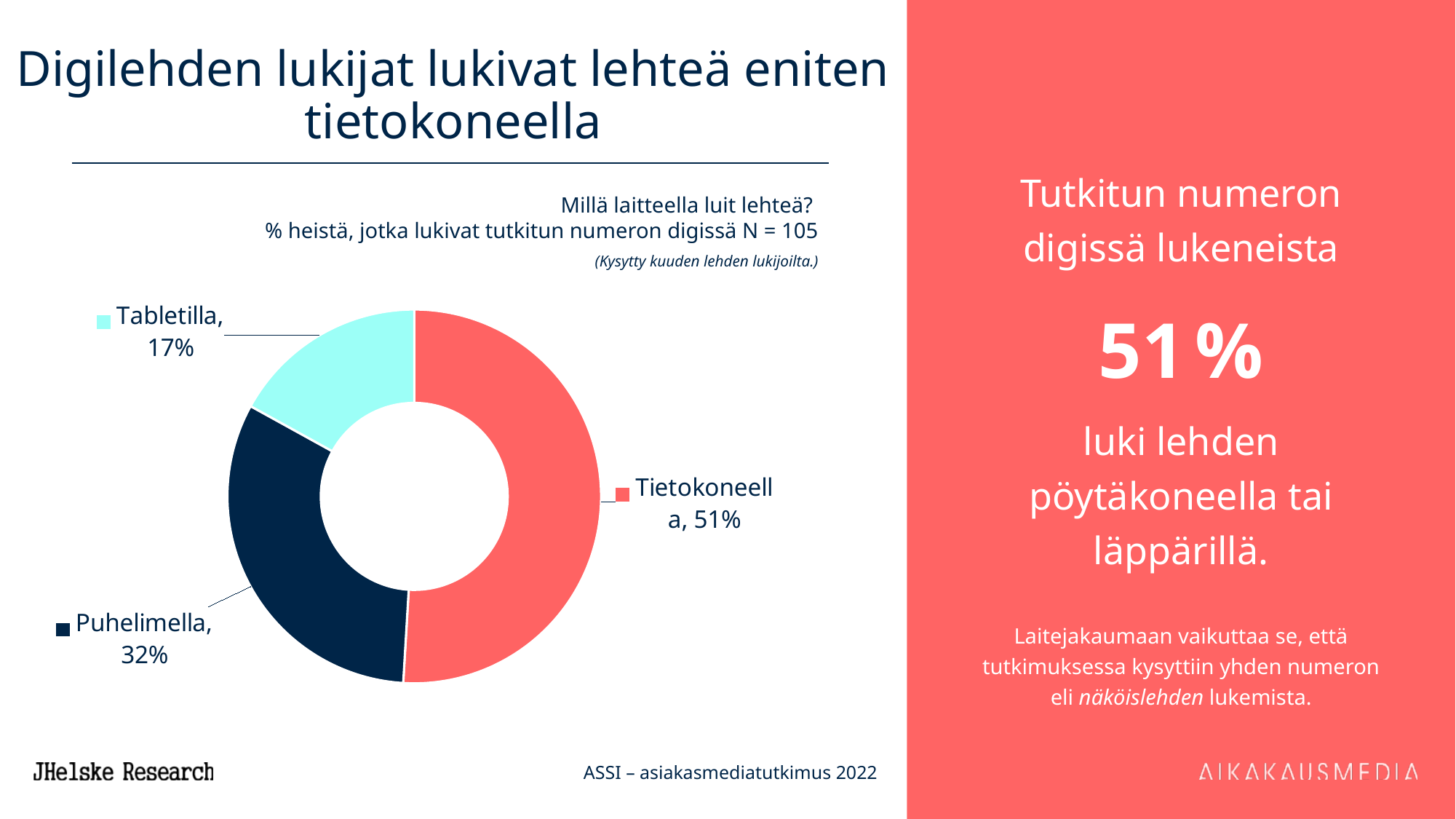
How many device categories are shown in the chart? 3 Which is larger, the share for Puhelimella or the share for Tabletilla? Puhelimella What percentage of readers read the magazine on a tablet (Tabletilla)? 17% What is the sample size (N) stated in the chart subtitle? 105 What is the difference in percentage points between Puhelimella and Tabletilla? 15 What percentage of readers read the magazine on a computer (Tietokoneella)? 51% Which device has the smallest share in the chart? Tabletilla What percentage of readers read the magazine on a phone (Puhelimella)? 32% Which device has the largest share in the chart? Tietokoneella What kind of chart is shown on the slide? Doughnut (pie) chart What colour is the Tietokoneella slice in the chart? Red (coral) What is the difference in percentage points between Tietokoneella and Puhelimella? 19